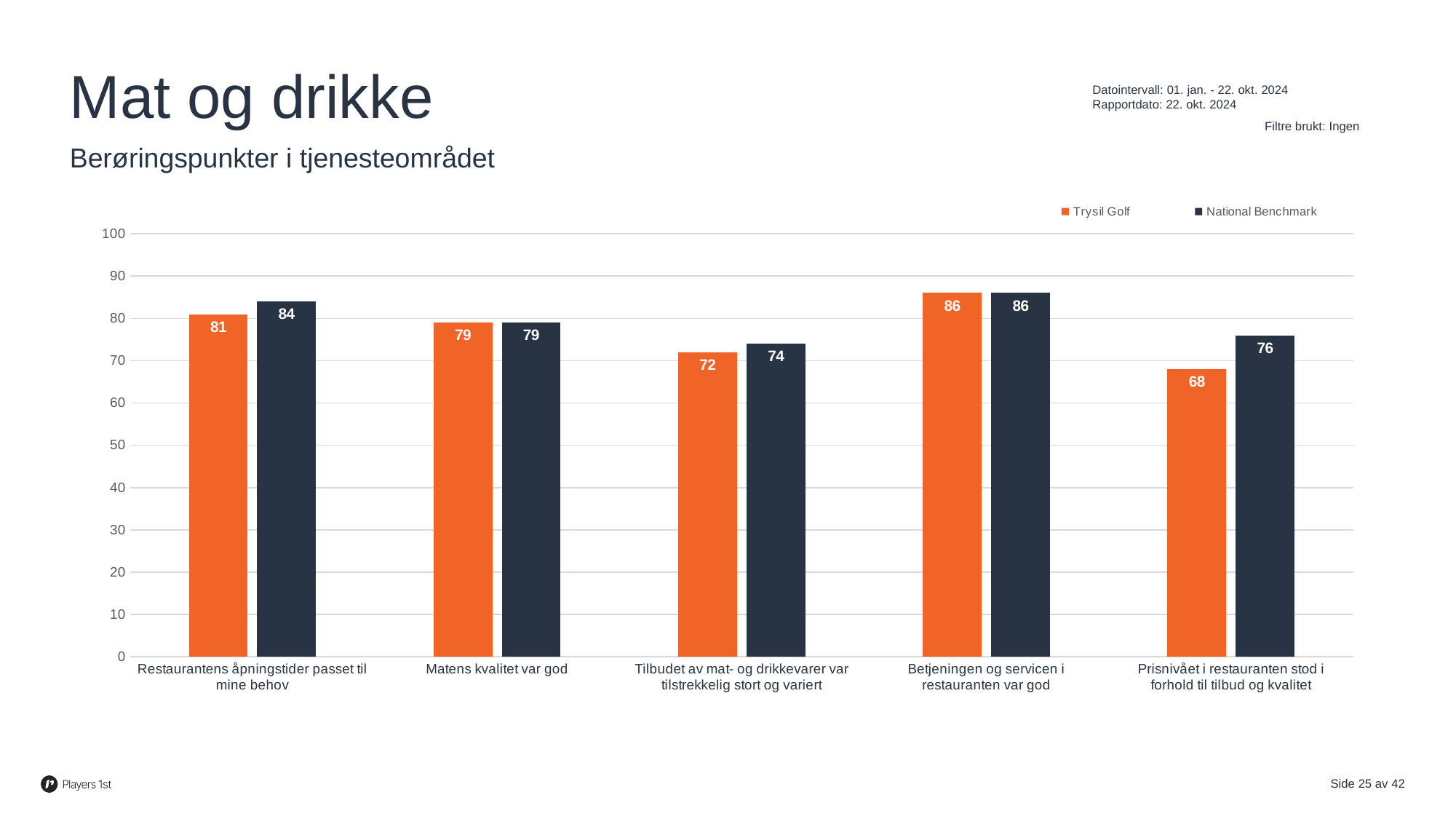
What is the Trysil Golf value for "Matens kvalitet var god"? 79 What is the Trysil Golf value for "Tilbudet av mat- og drikkevarer var tilstrekkelig stort og variert"? 72 For "Tilbudet av mat- og drikkevarer var tilstrekkelig stort og variert", which is larger: Trysil Golf or National Benchmark? National Benchmark Is the Trysil Golf value for "Prisnivået i restauranten stod i forhold til tilbud og kvalitet" greater or less than 70? less What kind of chart is shown on the slide? Bar chart Which category has the highest Trysil Golf value? Betjeningen og servicen i restauranten var god How many categories are shown on the x axis? 5 How many series does the legend list? 2 What is the difference between the National Benchmark and Trysil Golf values for "Prisnivået i restauranten stod i forhold til tilbud og kvalitet"? 8 What is the difference between the National Benchmark and Trysil Golf values for "Restaurantens åpningstider passet til mine behov"? 3 What is the National Benchmark value for "Prisnivået i restauranten stod i forhold til tilbud og kvalitet"? 76 Which category has the lowest Trysil Golf value? Prisnivået i restauranten stod i forhold til tilbud og kvalitet